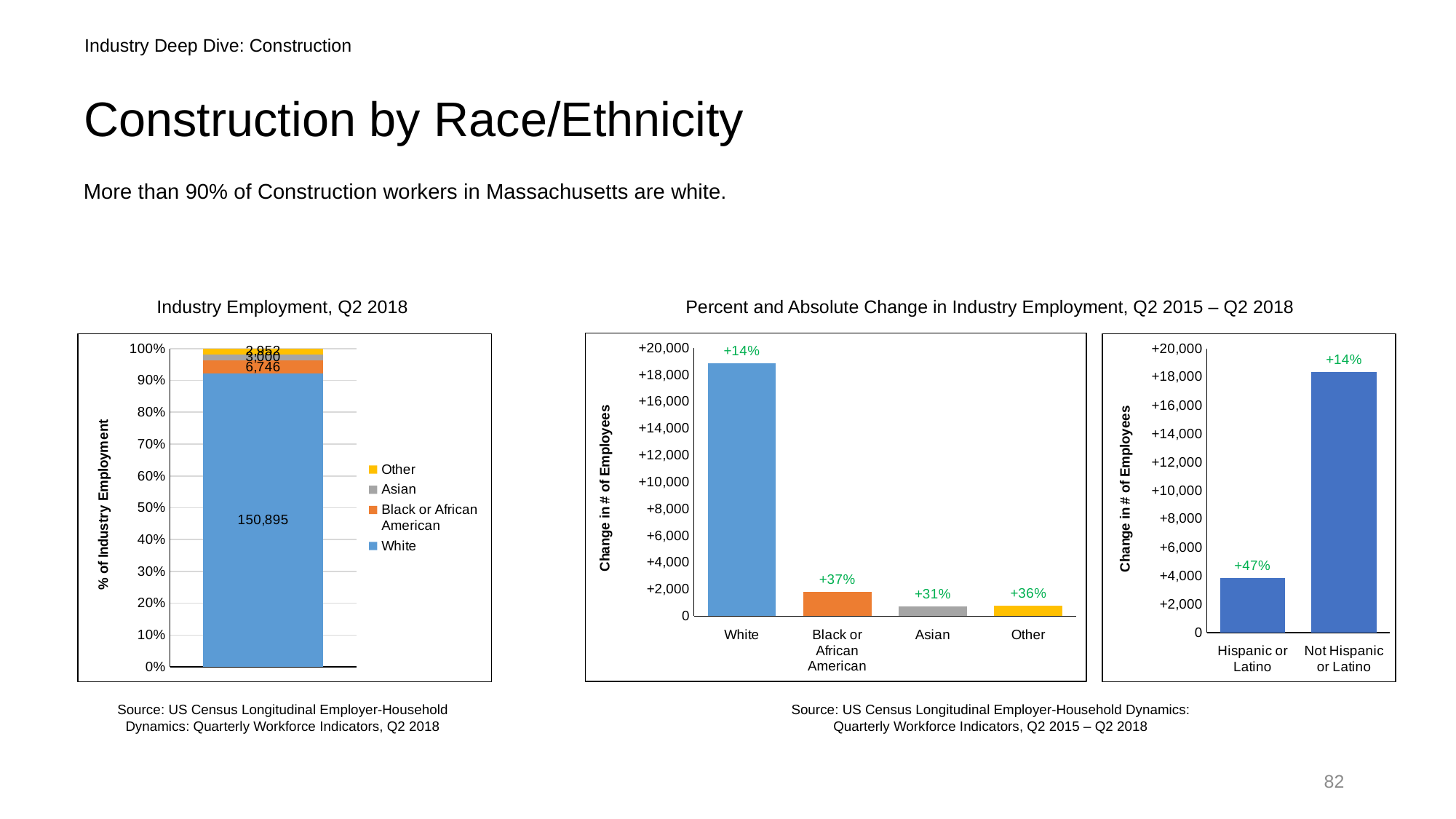
In the middle chart (Percent and Absolute Change in Industry Employment), which category has the largest absolute change in number of employees? White In the Industry Employment, Q2 2018 chart, how many series does the legend list? 4 In the middle chart (Percent and Absolute Change in Industry Employment), how many race categories are shown on the x axis? 4 In the Industry Employment, Q2 2018 chart, what is the value labeled for White? 150,895 In the middle chart (Percent and Absolute Change in Industry Employment), what is the percent change label shown for White? +14% In the rightmost chart, what is the percent change label shown for Hispanic or Latino? +47% In the rightmost chart, which category has the larger change in number of employees, Hispanic or Latino or Not Hispanic or Latino? Not Hispanic or Latino In the rightmost chart, is the change in number of employees for Not Hispanic or Latino greater or less than 16,000? greater In the middle chart (Percent and Absolute Change in Industry Employment), what is the percent change label shown for Asian? +31% In the middle chart (Percent and Absolute Change in Industry Employment), what is the percent change label shown for Black or African American? +37% In the middle chart (Percent and Absolute Change in Industry Employment), is the change in number of employees for White greater or less than 18,000? greater